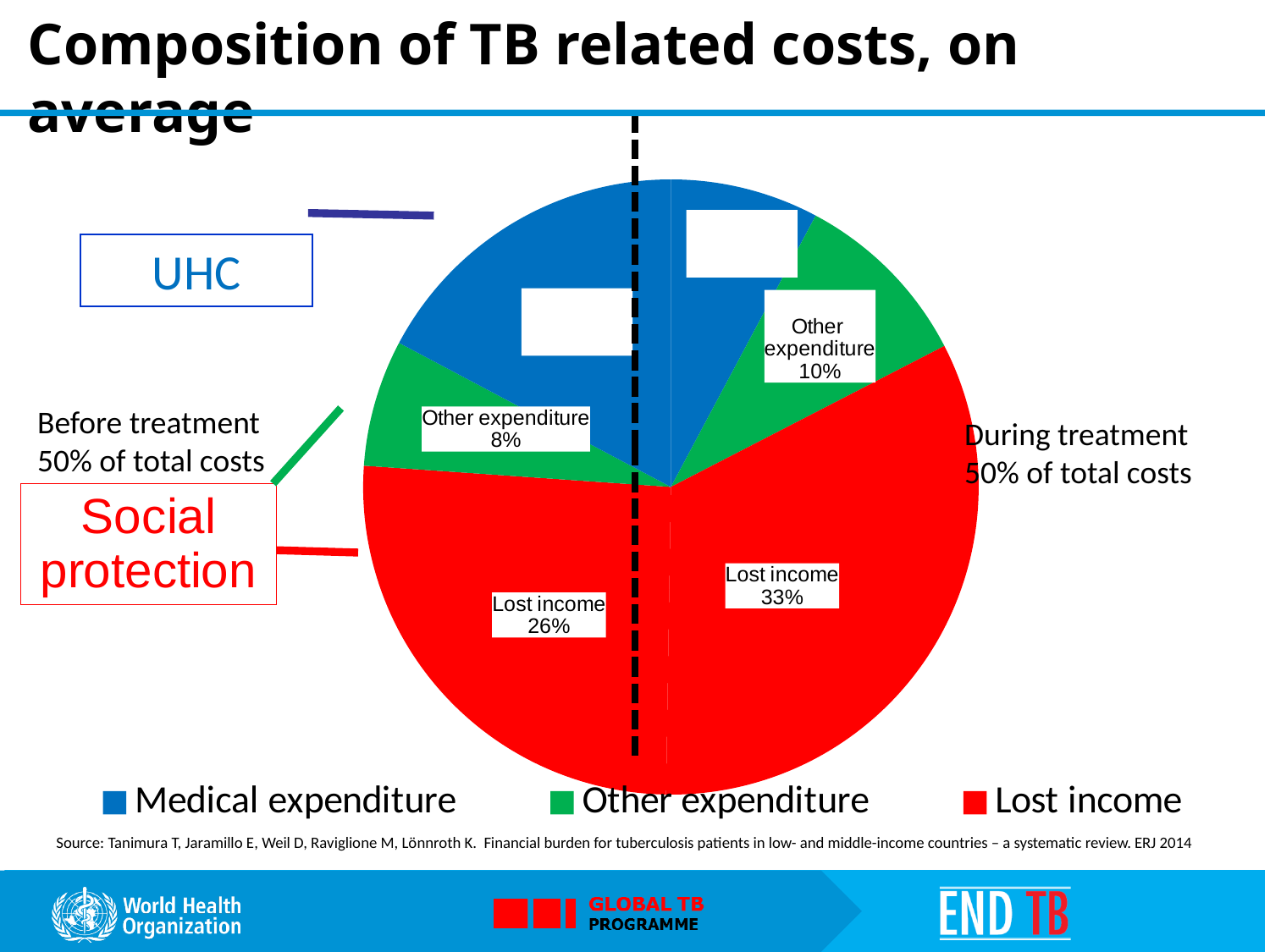
What percentage is labelled for lost income before treatment? 26% Which labelled slice of the pie is the largest? Lost income 33% (during treatment) What percentage is labelled for other expenditure before treatment? 8% What is the difference in percentage points between lost income during treatment and lost income before treatment? 7 What percentage is labelled for other expenditure during treatment? 10% How many entries does the chart legend list? 3 What is the title of the chart on the slide? Composition of TB related costs, on average Which is larger: other expenditure before treatment or other expenditure during treatment? Other expenditure during treatment According to the slide, what share of total costs is incurred before treatment? 50% What kind of chart is shown on the slide? pie chart What percentage is labelled for lost income during treatment? 33% How many slices does the pie chart have? 6